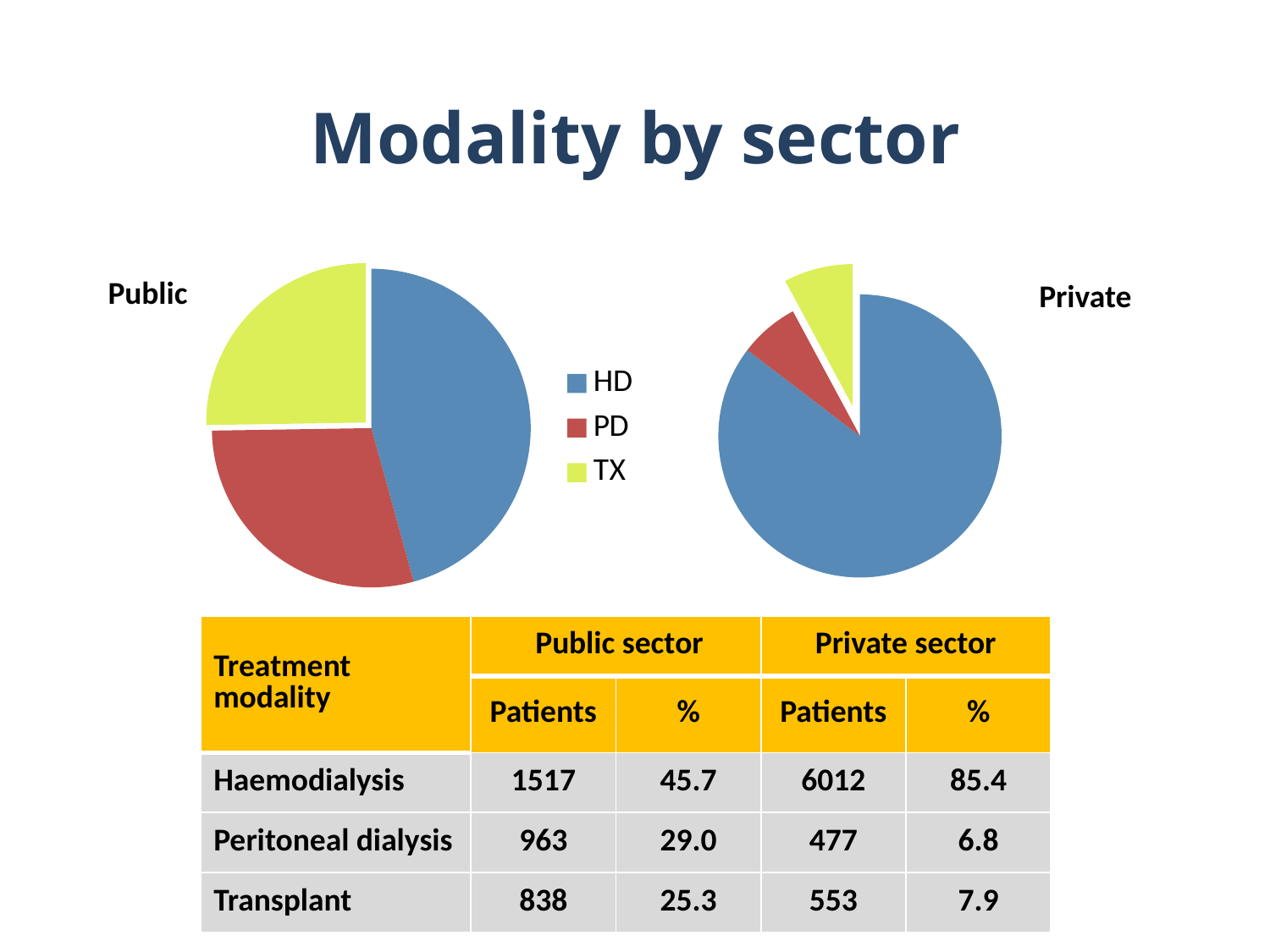
What type of charts are shown on the slide? Pie charts According to the table, how many private sector patients are on peritoneal dialysis? 477 What is the difference in the number of haemodialysis patients between the private and public sectors, according to the table? 4495 In the Public pie chart, which modality has the smallest slice? TX In the Private pie chart, which modality has the smallest slice? PD How many series does the legend list for the pie charts? 3 What is the title of the slide? Modality by sector According to the table, what percentage of public sector patients are on haemodialysis? 45.7 In the Private pie chart, which modality has the largest slice? HD According to the table, what percentage of private sector patients have a transplant? 7.9 In the Public pie chart, which modality has the largest slice? HD Is the HD slice larger in the Public pie chart or the Private pie chart? Private